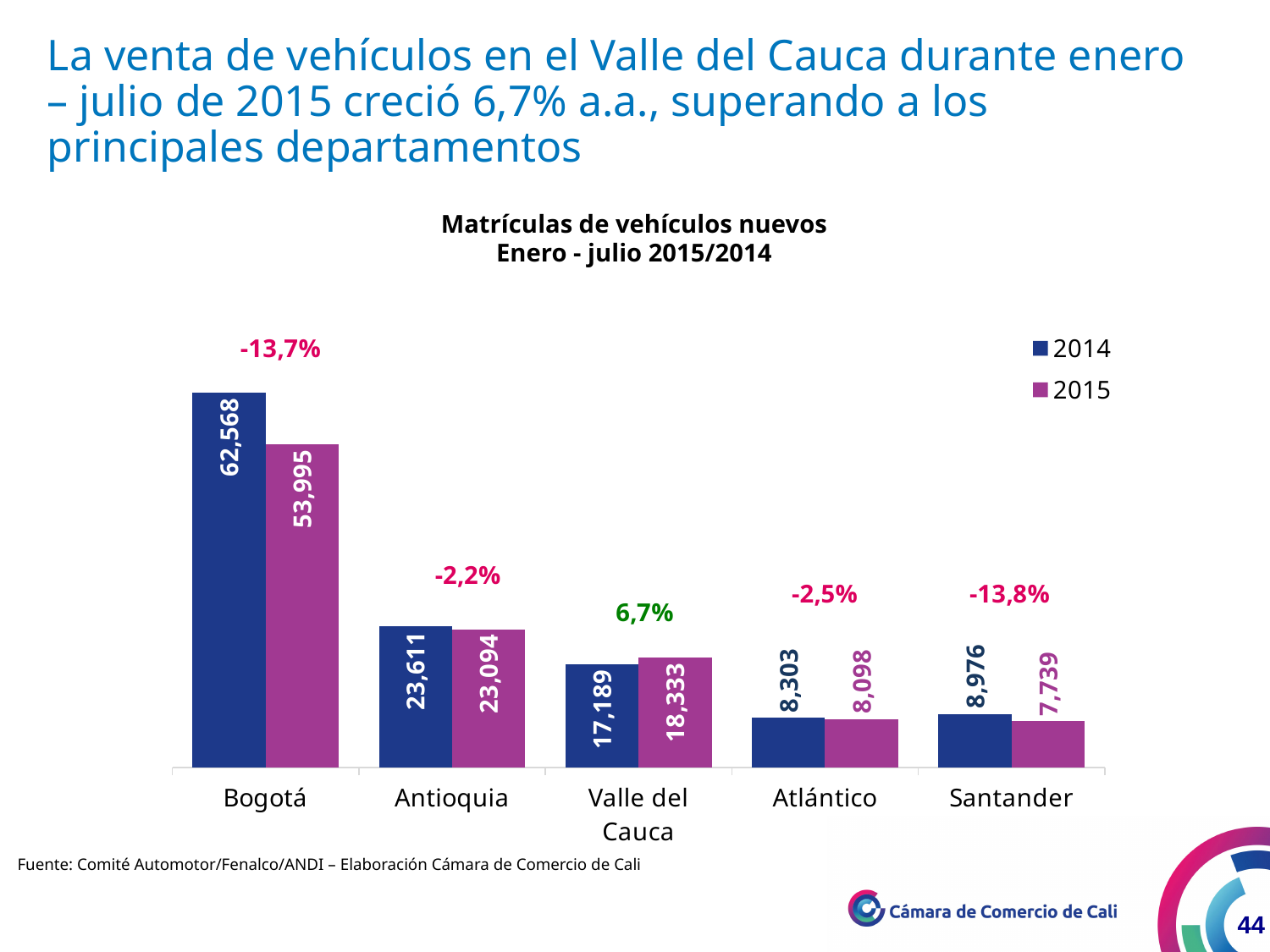
Which department has the lowest value in 2015? Santander What is the value for Bogotá in 2014? 62,568 What is the difference between the 2014 and 2015 values for Bogotá? 8,573 By how much did the value for Valle del Cauca increase from 2014 to 2015? 1,144 What is the value for Santander in 2015? 7,739 How many series does the legend list? 2 How many departments are shown on the x axis? 5 What is the value for Atlántico in 2014? 8,303 Which department has the highest value in 2015? Bogotá What percentage change is shown above the bars for Valle del Cauca? 6,7% Which is larger, the 2014 value for Atlántico or the 2014 value for Santander? Santander What is the value for Valle del Cauca in 2015? 18,333